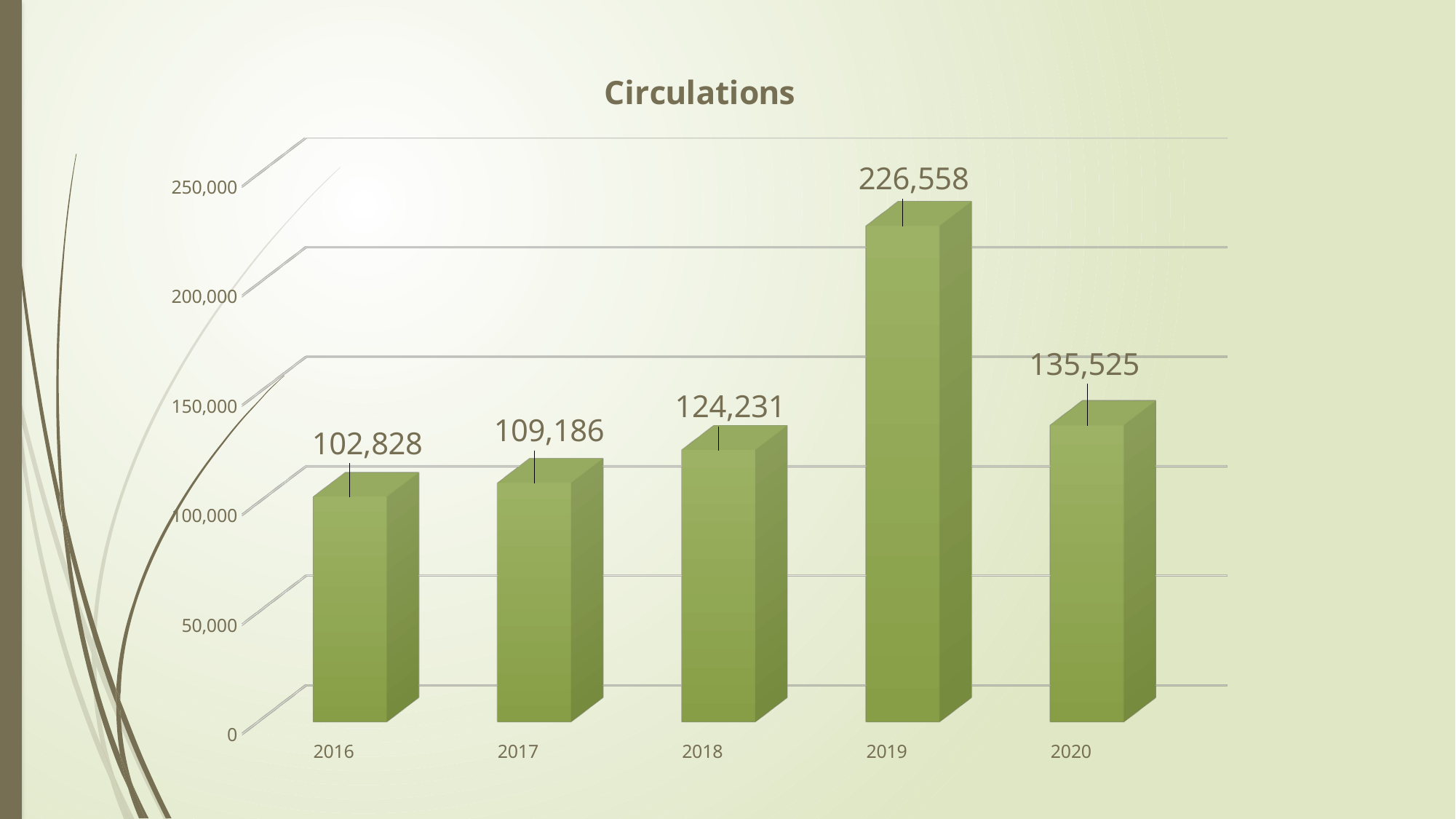
What is the value for 2016? 102,828 Which year has the highest value? 2019 Which is larger, the value for 2020 or the value for 2018? 2020 Which year has the lowest value? 2016 What is the difference between the values for 2018 and 2017? 15,045 What is the difference between the values for 2019 and 2020? 91,033 What is the value for 2020? 135,525 What is the value for 2019? 226,558 How many years are shown on the x axis? 5 Is the value for 2019 greater or less than 200,000? greater What kind of chart is shown? bar chart What is the title of the chart? Circulations